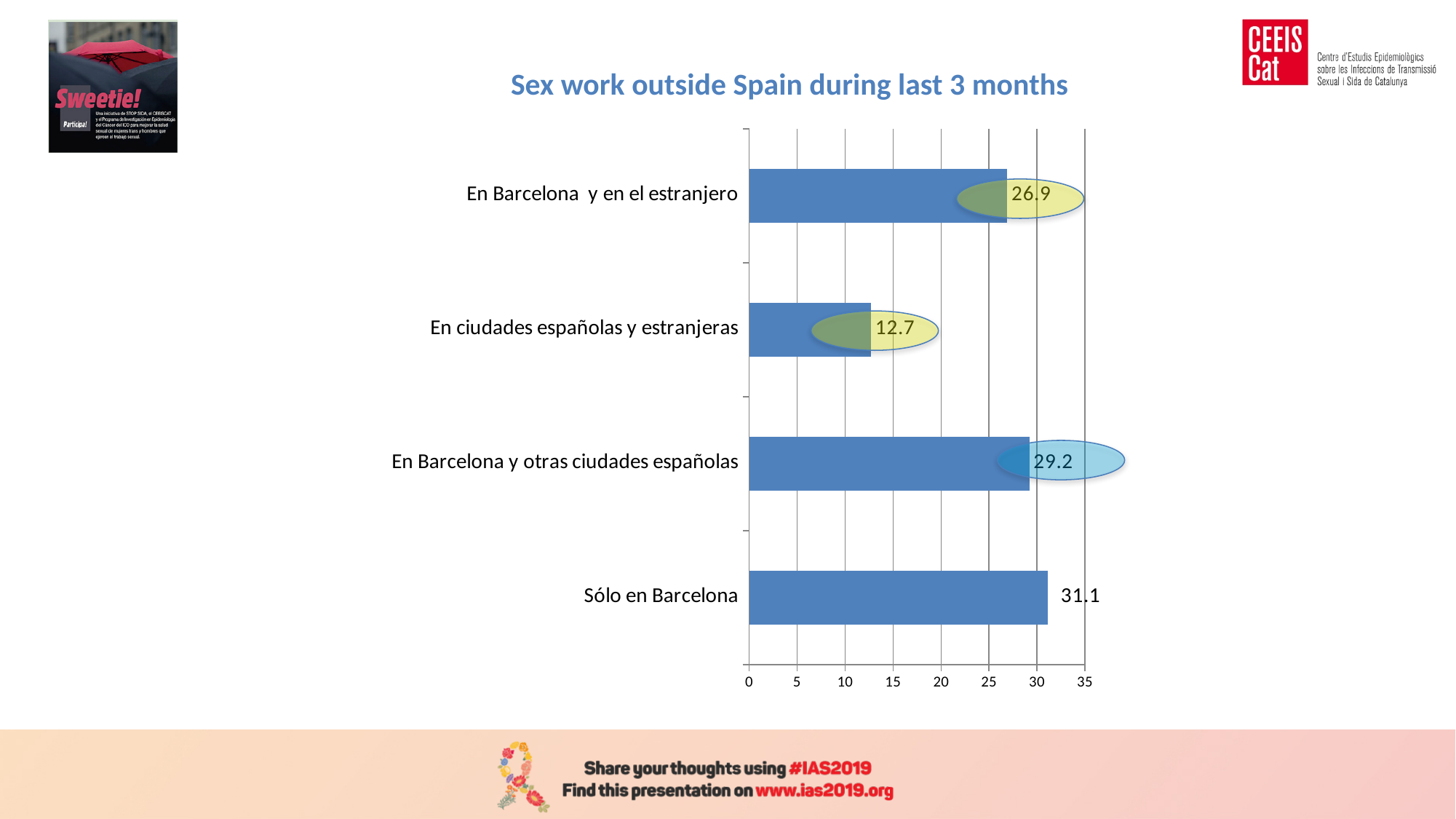
Is the value for "En ciudades españolas y estranjeras" greater or less than 15? less What is the title of the chart? Sex work outside Spain during last 3 months How many categories are shown in the chart? 4 Which is larger: the value for "En Barcelona y en el estranjero" or for "En Barcelona y otras ciudades españolas"? En Barcelona y otras ciudades españolas What is the value for "Sólo en Barcelona"? 31.1 Which category has the lowest value? En ciudades españolas y estranjeras What is the value for "En ciudades españolas y estranjeras"? 12.7 Which category has the highest value? Sólo en Barcelona What kind of chart is shown on the slide? Bar chart What is the value for "En Barcelona y en el estranjero"? 26.9 What is the difference between the values for "Sólo en Barcelona" and "En ciudades españolas y estranjeras"? 18.4 What is the value for "En Barcelona y otras ciudades españolas"? 29.2